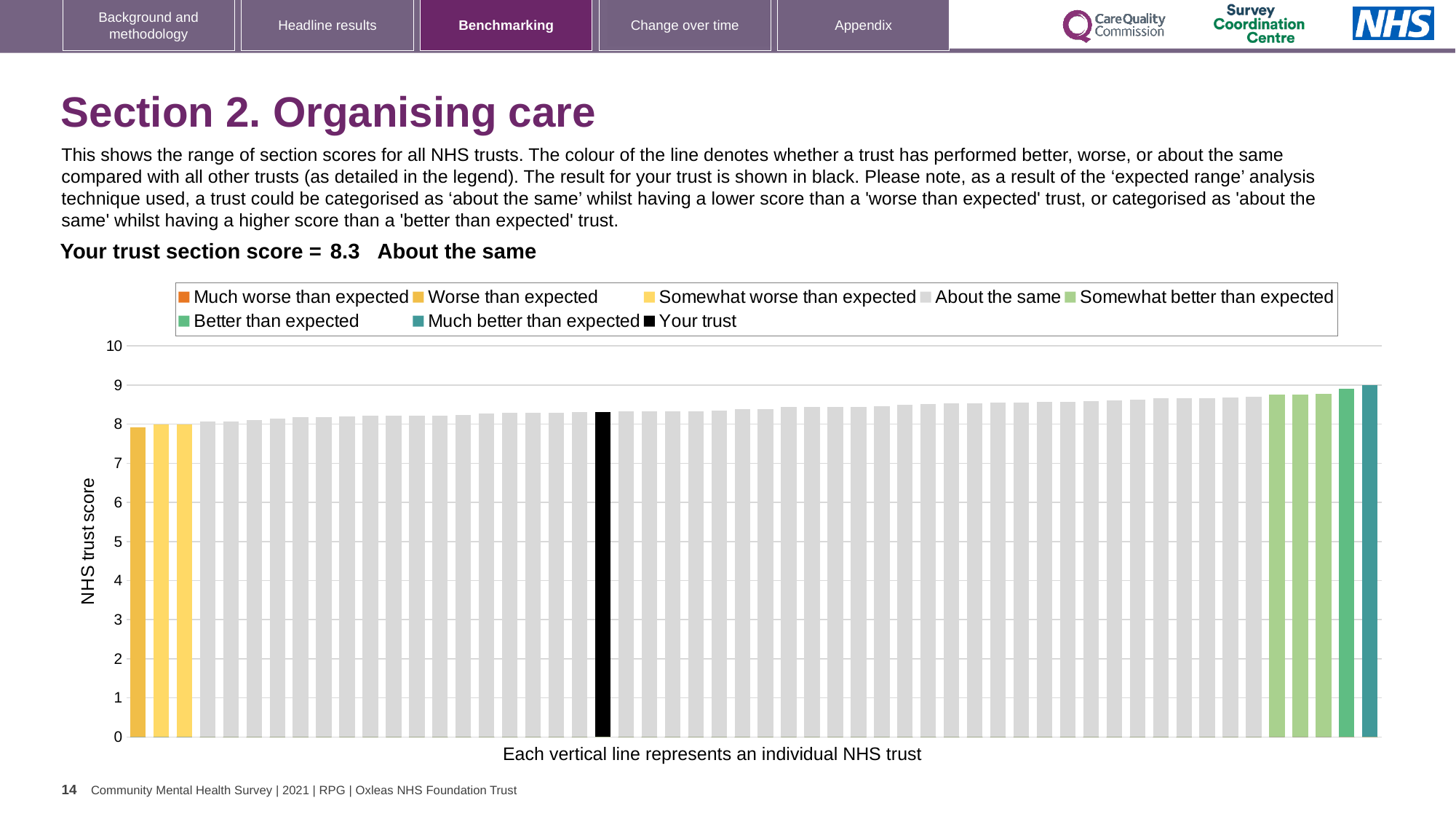
Which category is Your trust placed in for this section? About the same How many entries does the chart legend list? 8 What is the label on the vertical axis? NHS trust score What colour is the bar representing Your trust? Black What is the section score for Your trust? 8.3 Is the value of the shortest bar greater or less than 9? less Is the value for Your trust larger or smaller than the tallest bar on the chart? smaller Is the value for Your trust greater or less than 9? less Do the bar values rise or fall from left to right along the x axis? rise Is the value for Your trust greater or less than 8? greater What kind of chart is shown on the slide? Bar chart